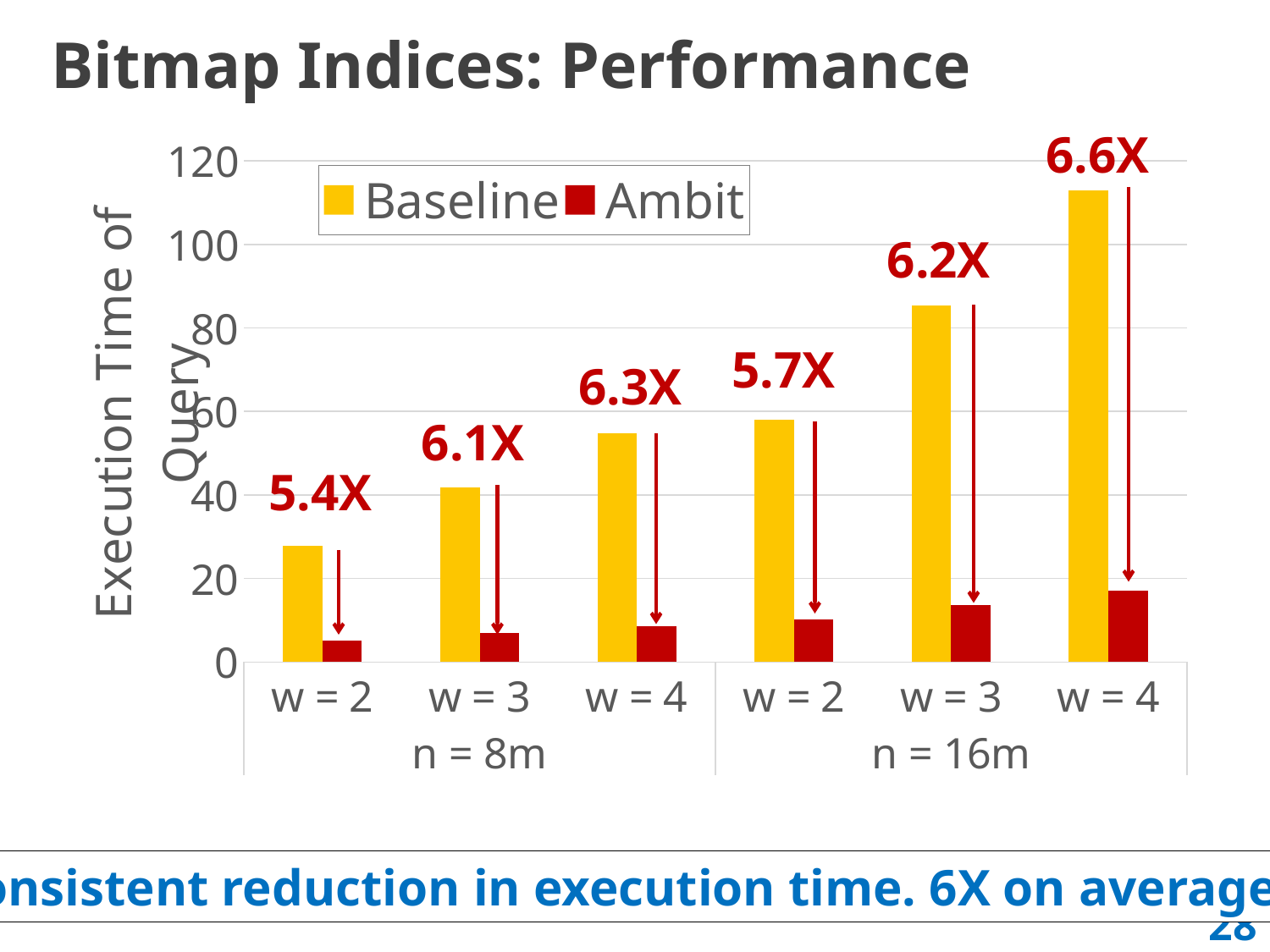
Which category has the highest Baseline execution time? w = 4, n = 16m Which category has the lowest Baseline execution time? w = 2, n = 8m Is the Ambit value for w = 3 at n = 16m greater or less than 20? less How many w-value categories are plotted along the x axis? 6 What speedup is annotated above the bars for w = 3 at n = 16m? 6.2X Which is larger, the Baseline value for w = 3 at n = 8m or the Baseline value for w = 2 at n = 16m? w = 2 at n = 16m What kind of chart is shown on the slide? bar chart What speedup is annotated above the bars for w = 2 at n = 8m? 5.4X How many series does the legend list? 2 Do the Baseline execution times rise or fall as w increases within the n = 8m group? rise Is the Baseline value for w = 4 at n = 16m greater or less than 100? greater What speedup is annotated above the bars for w = 4 at n = 16m? 6.6X